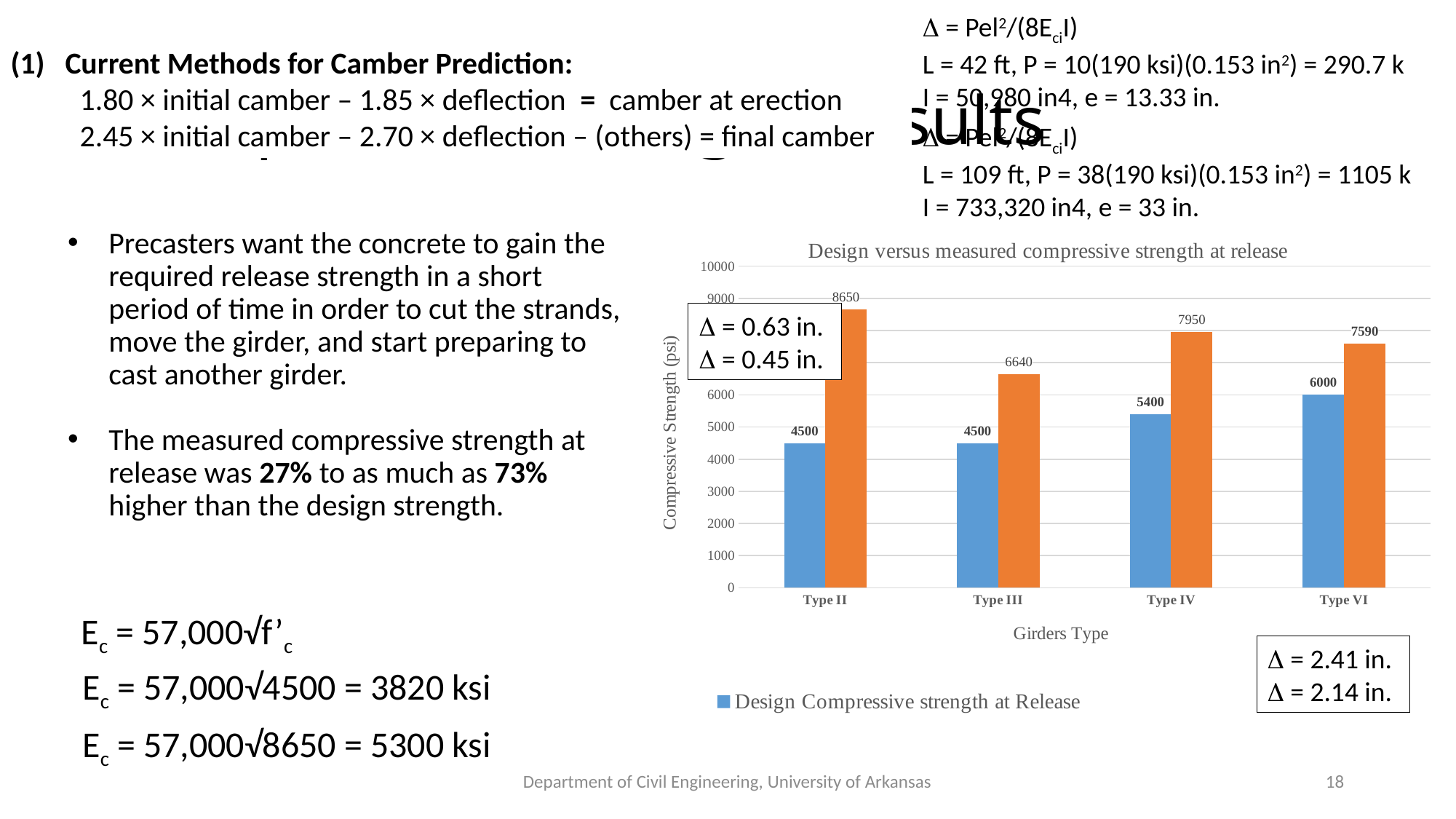
What is the title of the chart? Design versus measured compressive strength at release Which girder type has the highest Design Compressive strength at Release? Type VI How many girder types are shown on the x axis? 4 What is the Design Compressive strength at Release for Type IV? 5400 What is the difference between the orange bar and the blue bar for Type VI? 1590 What is the difference between the orange bar and the blue bar for Type II? 4150 What value is shown on the orange bar for Type III? 6640 What kind of chart is shown on the slide? bar chart Which girder type has the lowest orange bar? Type III Which has the larger orange bar, Type IV or Type VI? Type IV Which girder type has the highest orange bar? Type II Is the orange bar for Type VI greater or less than 7000? greater